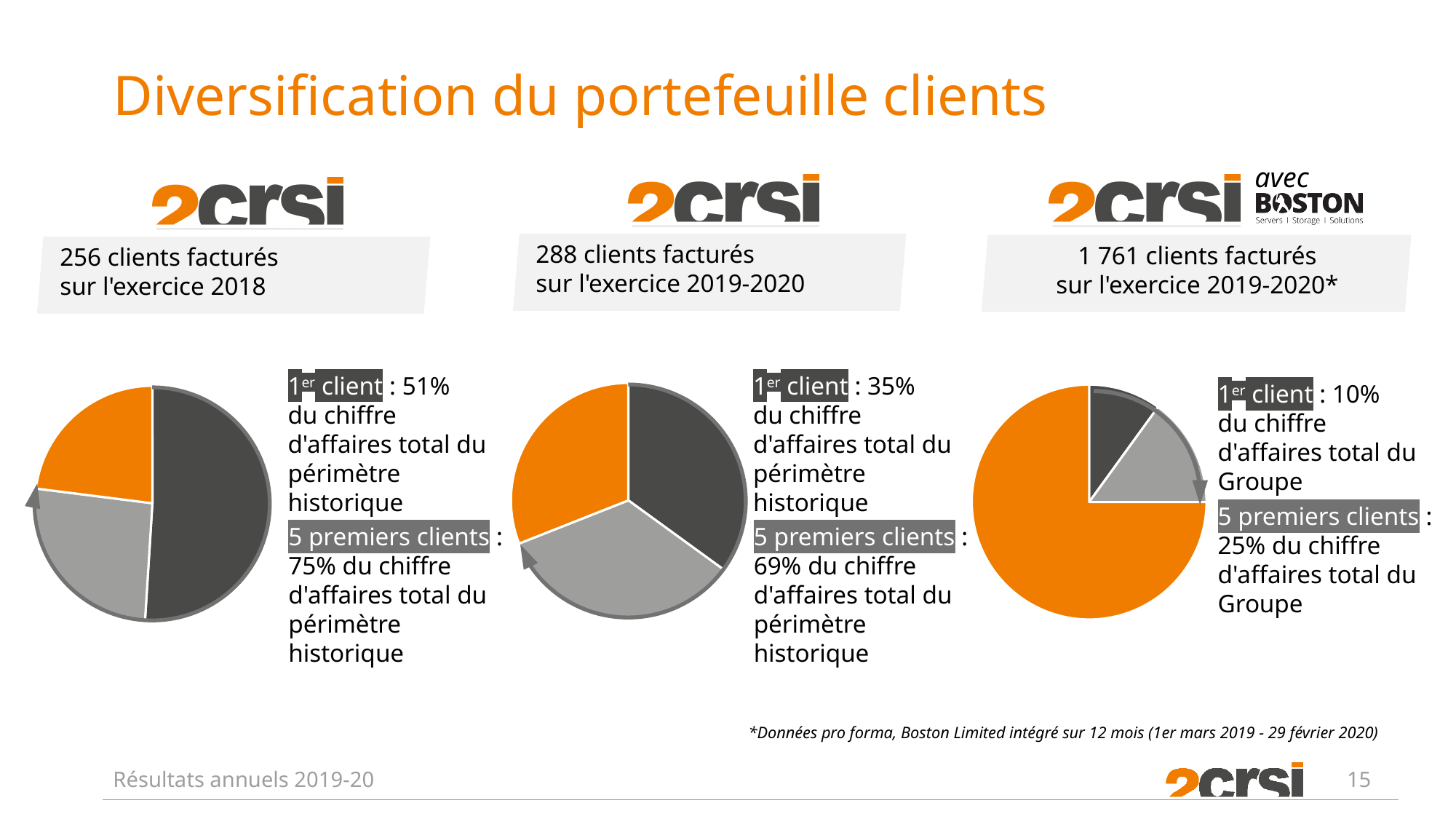
In the right pie chart (avec Boston), what colour is the largest slice? Orange In the left pie chart (exercice 2018), what share of revenue do the 5 premiers clients represent? 75% In the right pie chart (avec Boston), what share of the Group's revenue do the 5 premiers clients represent? 25% In the middle pie chart (288 clients facturés sur l'exercice 2019-2020), what share of revenue does the 1er client represent? 35% What kind of charts are shown on the slide? Pie charts How many pie charts are on the slide? 3 In the right pie chart (1 761 clients facturés sur l'exercice 2019-2020*), what share of the Group's revenue does the 1er client represent? 10% Which of the three pie charts shows the largest share for the 1er client? The left pie chart (exercice 2018) Is the 1er client's share larger in the middle pie chart (35%) or in the right pie chart (10%)? The middle pie chart In the middle pie chart (exercice 2019-2020), what share of revenue do the 5 premiers clients represent? 69% In the left pie chart (256 clients facturés sur l'exercice 2018), what share of revenue does the 1er client represent? 51% By how many percentage points did the 1er client's share fall between the left pie chart (2018) and the middle pie chart (2019-2020)? 16 percentage points